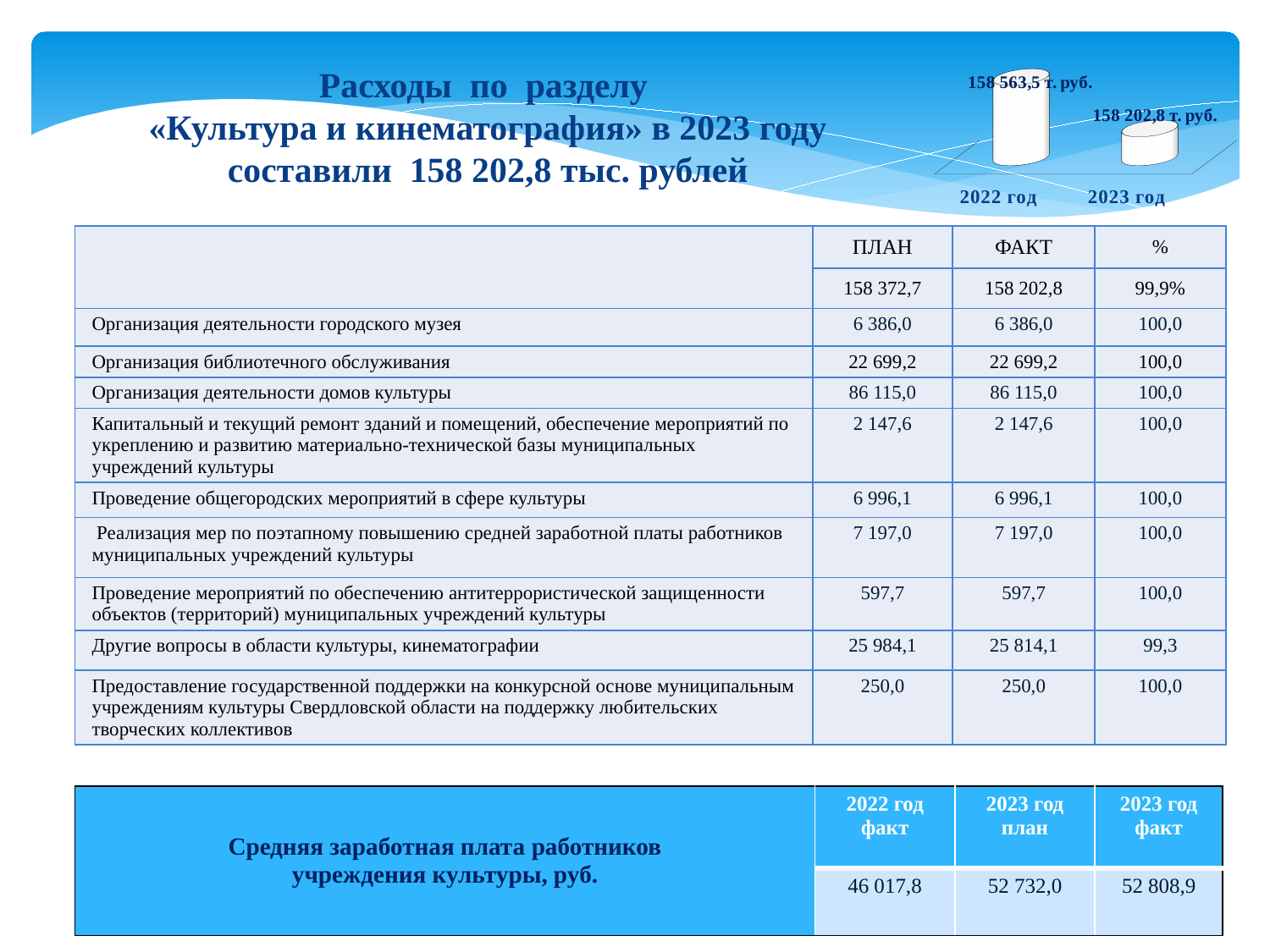
In the chart at the top right of the slide, what is the value shown for 2022 год? 158 563,5 т. руб. What are the category labels on the x axis of the chart at the top right of the slide? 2022 год, 2023 год In the chart at the top right of the slide, what is the value shown for 2023 год? 158 202,8 т. руб. In the chart at the top right of the slide, is the value for 2023 год larger or smaller than the value for 2022 год? smaller What kind of chart is shown at the top right of the slide? bar chart In the chart at the top right of the slide, by how much does the value for 2022 год exceed the value for 2023 год? 360,7 т. руб. In the chart at the top right of the slide, which year has the lower value? 2023 год How many categories are plotted in the chart at the top right of the slide? 2 In the chart at the top right of the slide, do the values rise or fall from 2022 год to 2023 год? fall In the chart at the top right of the slide, which year has the higher value? 2022 год